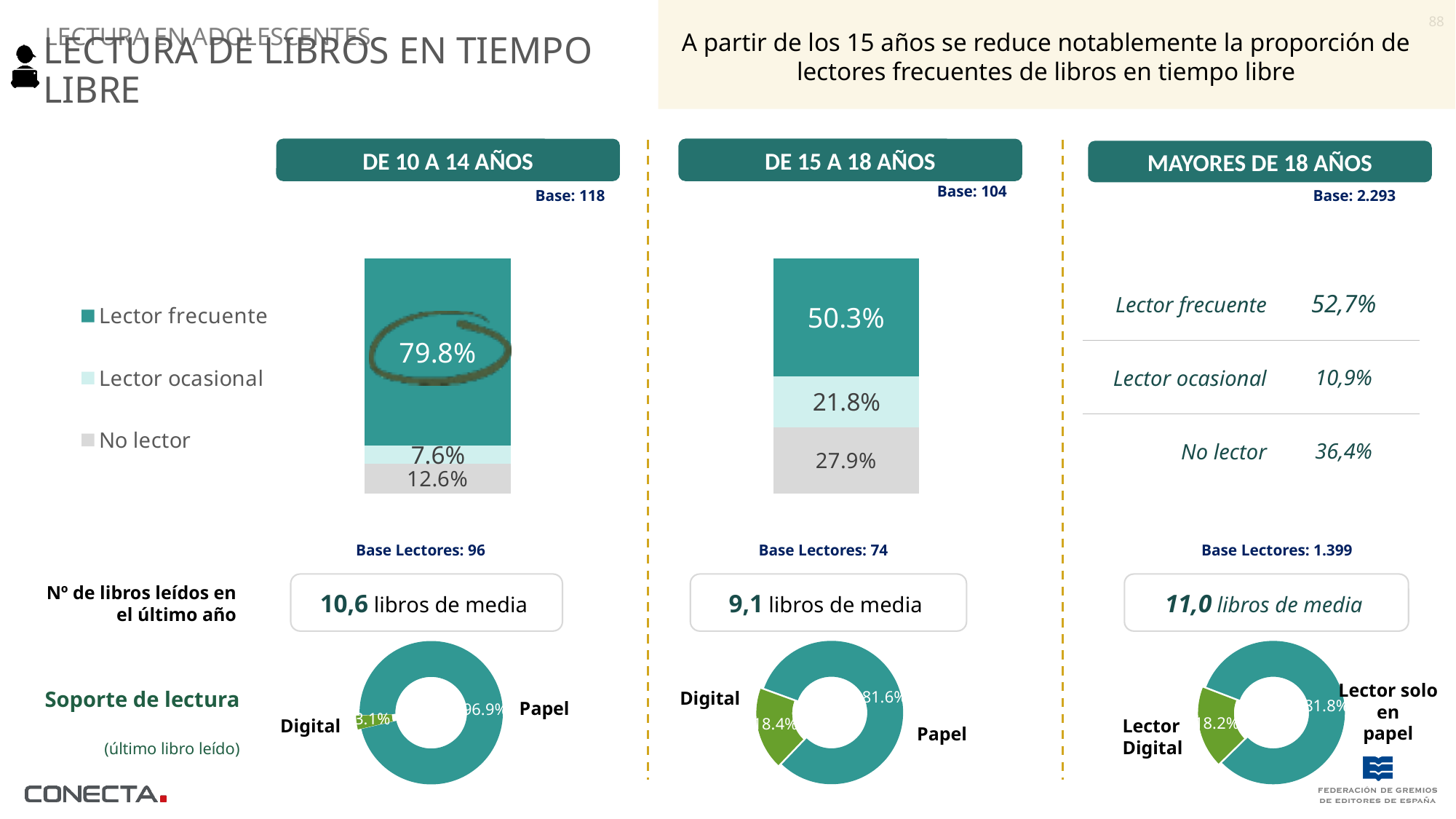
What kind of chart is used for 'Soporte de lectura' in each age group? Donut chart In the 'Soporte de lectura' donut chart for 'MAYORES DE 18 AÑOS', what share is Lector Digital? 18.2% In the stacked bar chart for 'DE 10 A 14 AÑOS', which segment is the smallest? Lector ocasional What is the total of the three segments in the 'DE 15 A 18 AÑOS' stacked bar? 100% In the stacked bar chart for 'DE 10 A 14 AÑOS', what is the value for Lector frecuente? 79.8% How many series does the legend of the stacked bar charts list? 3 In the stacked bar chart for 'DE 15 A 18 AÑOS', what is the value for Lector ocasional? 21.8% In the stacked bar chart for 'DE 15 A 18 AÑOS', what is the value for No lector? 27.9% In the 'Soporte de lectura' donut chart for 'DE 10 A 14 AÑOS', what share is Digital? 3.1% Which is larger: No lector in the 'DE 10 A 14 AÑOS' chart or No lector in the 'DE 15 A 18 AÑOS' chart? DE 15 A 18 AÑOS What is the difference between the Lector frecuente values in the 'DE 10 A 14 AÑOS' and 'DE 15 A 18 AÑOS' bar charts? 29.5 percentage points In the 'Soporte de lectura' donut chart for 'DE 15 A 18 AÑOS', what share is Papel? 81.6%